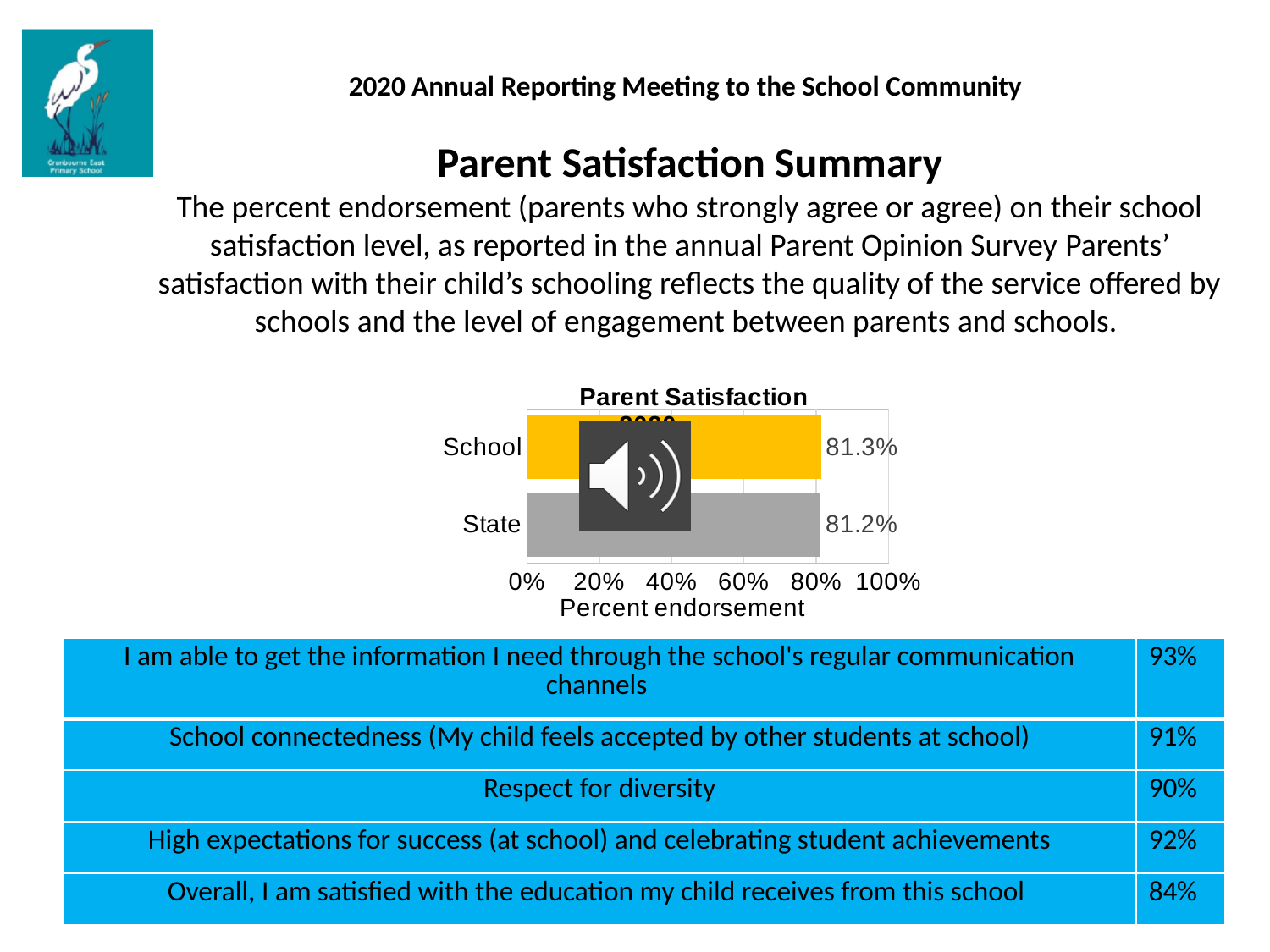
What is the value for School in the Parent Satisfaction chart? 81.3% What is the label on the horizontal axis of the Parent Satisfaction chart? Percent endorsement What is the maximum value shown on the horizontal axis of the Parent Satisfaction chart? 100% Which category has the lowest value in the Parent Satisfaction chart? State How many categories are shown in the Parent Satisfaction chart? 2 Is the value for School in the Parent Satisfaction chart greater or less than 80%? greater What is the difference between the School and State values in the Parent Satisfaction chart? 0.1% What kind of chart is the Parent Satisfaction chart? Bar chart Which category has the higher value in the Parent Satisfaction chart, School or State? School Is the value for State in the Parent Satisfaction chart greater or less than 100%? less What is the value for State in the Parent Satisfaction chart? 81.2%